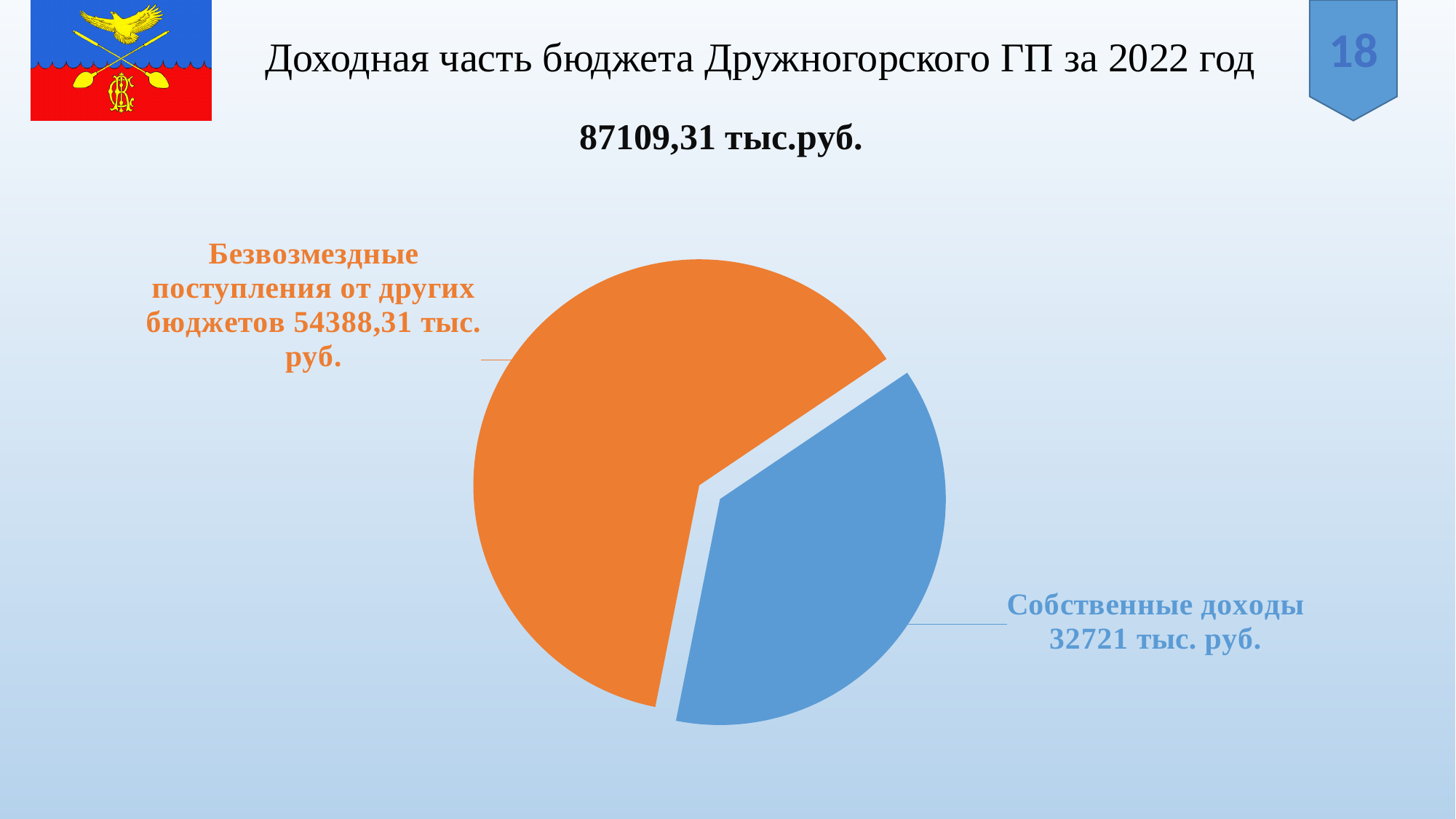
Which is larger: «Собственные доходы» or «Безвозмездные поступления от других бюджетов»? Безвозмездные поступления от других бюджетов What is the difference between «Безвозмездные поступления от других бюджетов» and «Собственные доходы»? 21667,31 тыс. руб. Which slice of the pie chart is the smallest? Собственные доходы What colour is the slice for «Собственные доходы»? Blue What is the value of the slice labelled «Собственные доходы»? 32721 тыс. руб. How many slices does the pie chart have? 2 What is the total of the two slices shown in the pie chart? 87109,31 тыс.руб. Which slice of the pie chart is the largest? Безвозмездные поступления от других бюджетов What kind of chart is shown on the slide? Pie chart What is the value of the slice labelled «Безвозмездные поступления от других бюджетов»? 54388,31 тыс. руб.